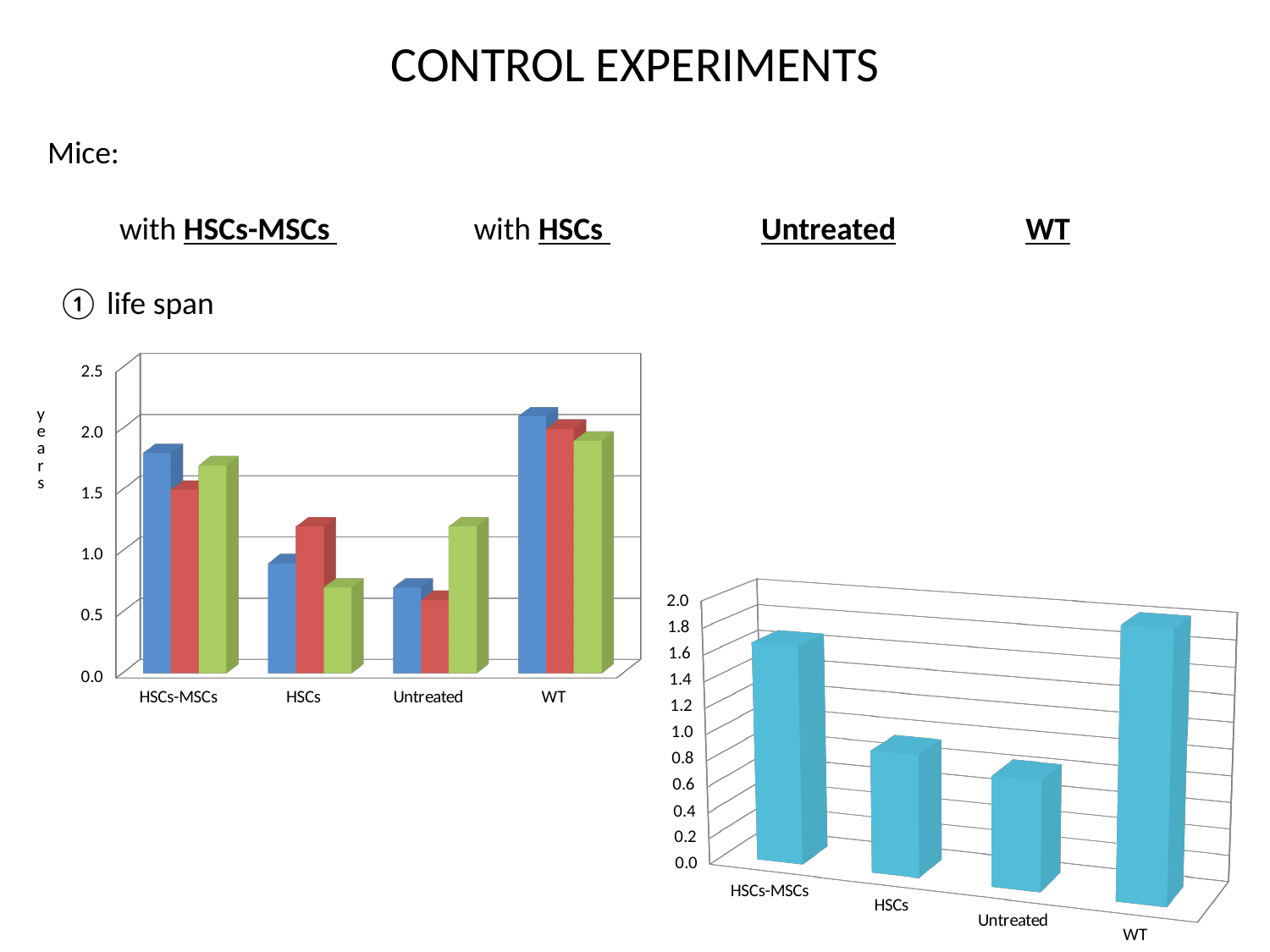
In the chart on the left, is the red bar for Untreated greater or less than 1.0? less In the chart on the left, is the green bar for HSCs greater or less than 1.0? less In the chart on the left, is the blue bar for HSCs-MSCs greater or less than 1.5? greater In the chart on the left, which category has the shortest blue bar? Untreated What kind of chart is the chart on the left of the slide? bar chart How many categories are shown on the x axis of the chart on the left? 4 In the chart on the right, which is larger, the value for HSCs or the value for Untreated? HSCs What is the label on the vertical axis of the chart on the left? years In the chart on the right, which category has the highest value? WT In the chart on the right, which category has the lowest value? Untreated In the chart on the left, which category has the tallest blue bar? WT